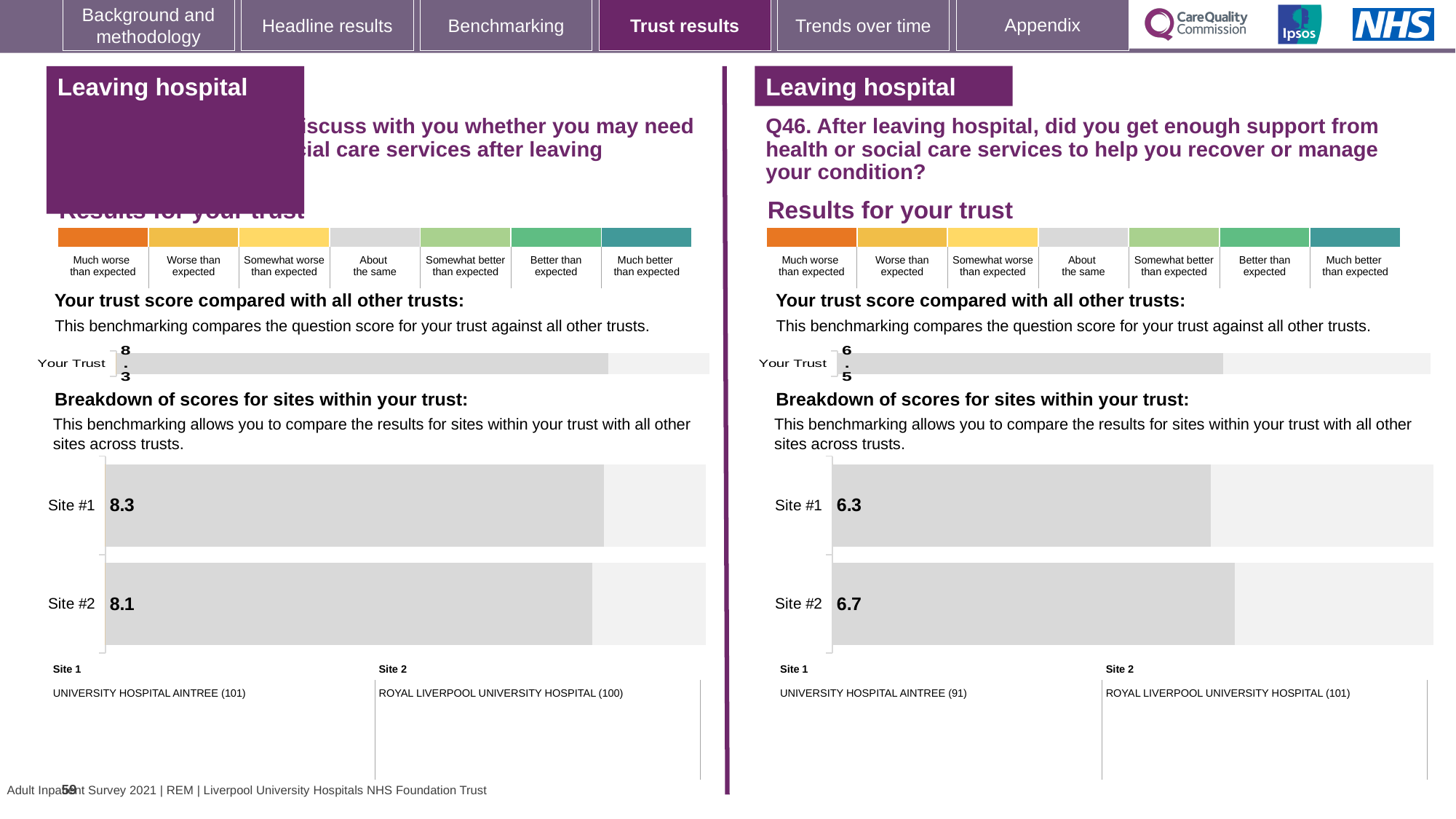
What kind of chart is the 'Breakdown of scores for sites within your trust' chart on the left-hand side? Bar chart On the right-hand (Q46) 'Your trust score compared with all other trusts' chart, what is the value for Your Trust? 6.5 On the left-hand 'Your trust score compared with all other trusts' chart, what is the value for Your Trust? 8.3 On the left-hand 'Breakdown of scores for sites within your trust' chart, which site has the highest score? Site #1 On the left-hand 'Breakdown of scores for sites within your trust' chart, what is the difference between Site #1 and Site #2? 0.2 On the right-hand (Q46) 'Breakdown of scores for sites within your trust' chart, which site has the lowest score? Site #1 How many sites are shown on the right-hand (Q46) 'Breakdown of scores for sites within your trust' chart? 2 On the right-hand (Q46) 'Breakdown of scores for sites within your trust' chart, what is the value for Site #2? 6.7 On the right-hand (Q46) 'Breakdown of scores for sites within your trust' chart, what is the value for Site #1? 6.3 On the left-hand 'Breakdown of scores for sites within your trust' chart, what is the value for Site #2? 8.1 On the right-hand (Q46) 'Breakdown of scores for sites within your trust' chart, what is the difference between Site #2 and Site #1? 0.4 Comparing the two 'Your Trust' charts, is the left-hand trust score or the right-hand (Q46) trust score larger? The left-hand trust score (8.3)